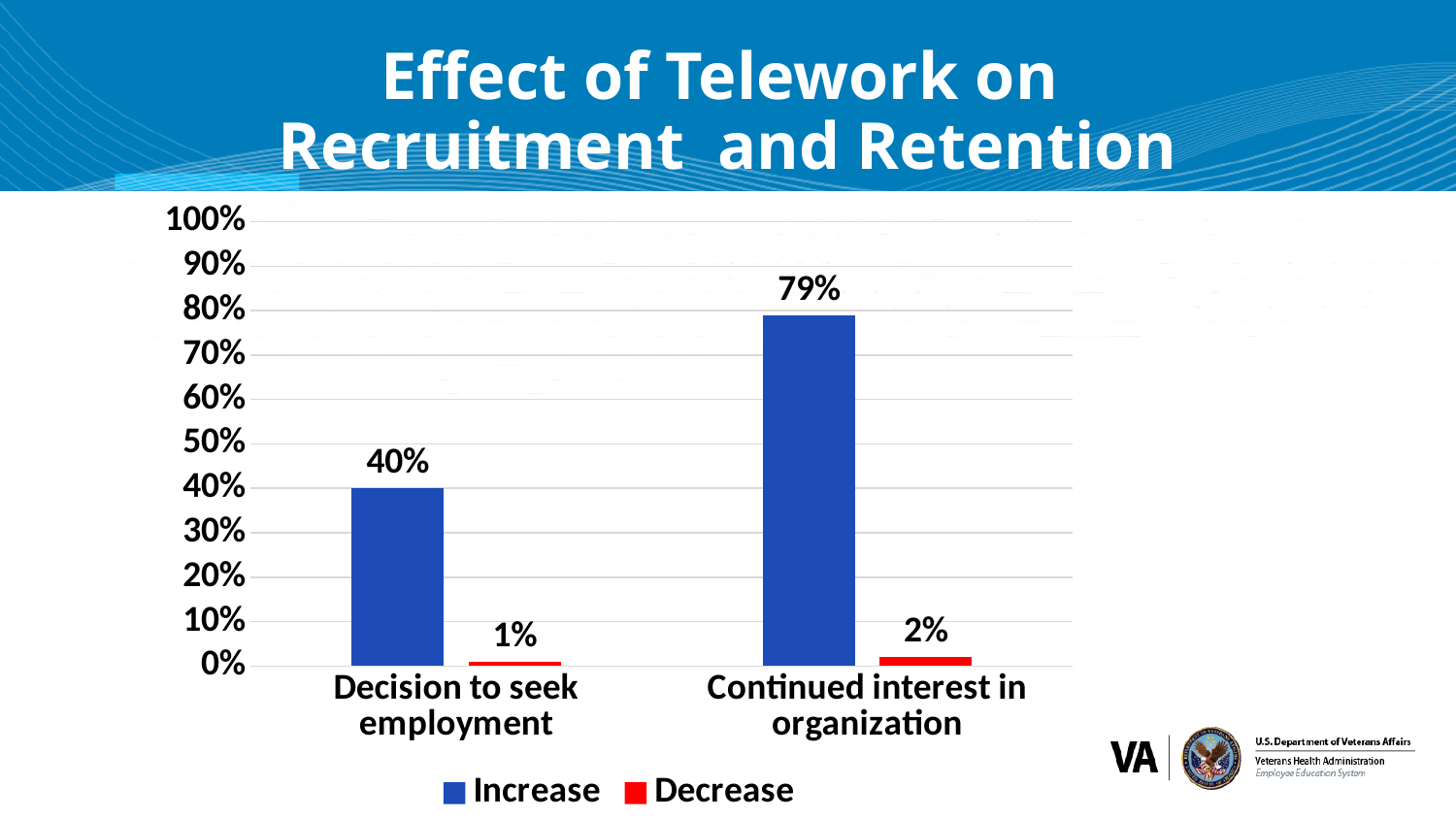
What is the Decrease value for Continued interest in organization? 2% Is the Increase value for Decision to seek employment larger or smaller than the Increase value for Continued interest in organization? smaller What is the difference between the Increase values for Continued interest in organization and Decision to seek employment? 39% What is the Decrease value for Decision to seek employment? 1% Which category has the highest Increase value? Continued interest in organization What is the Increase value for Decision to seek employment? 40% What is the Increase value for Continued interest in organization? 79% Which category has the lowest Decrease value? Decision to seek employment How many categories are shown on the x axis? 2 How many series does the legend list? 2 Is the Increase value for Continued interest in organization greater or less than 70%? greater What kind of chart is shown on the slide? bar chart